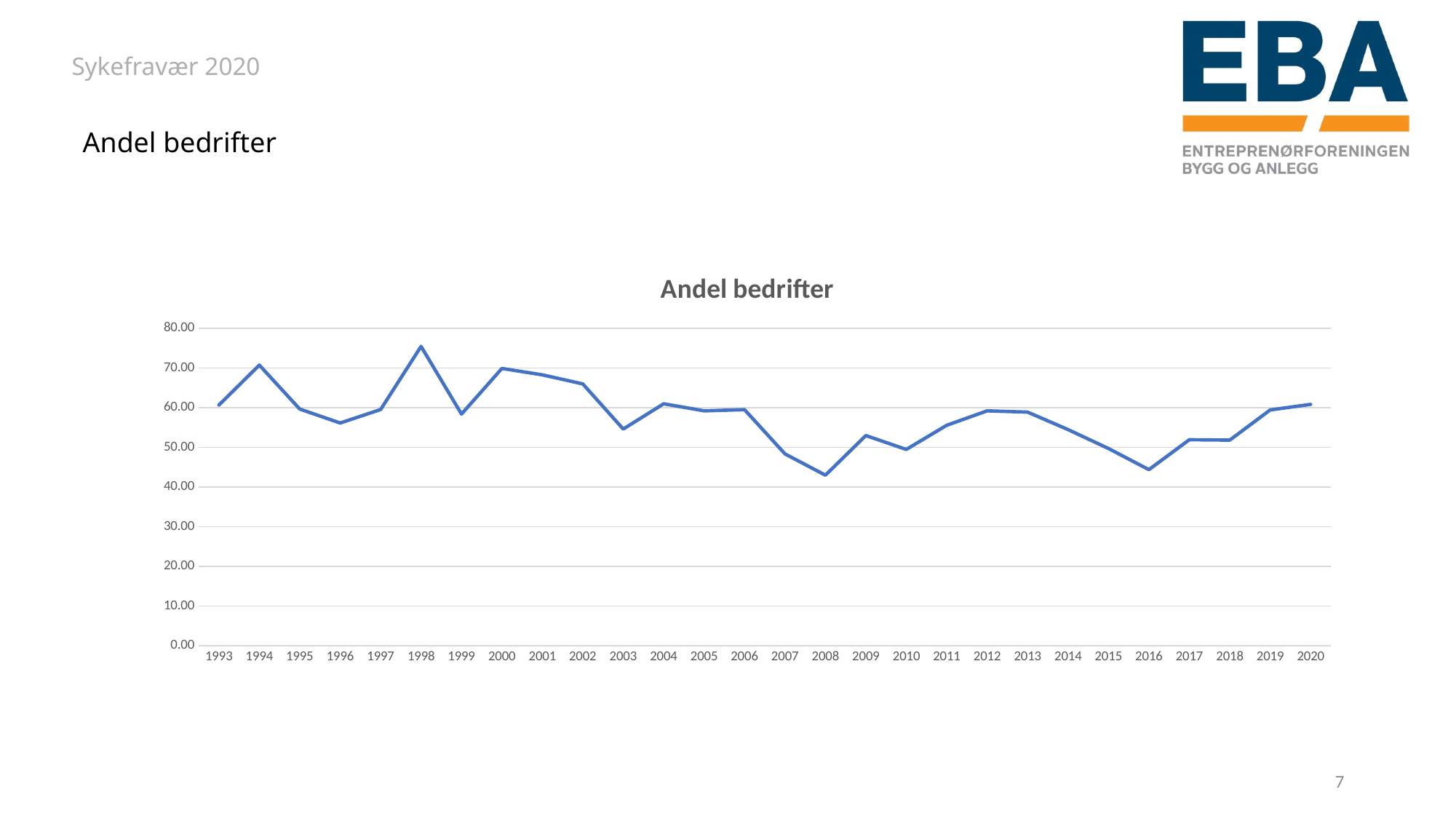
Do the values rise or fall from 2016 to 2020? rise What kind of chart is shown on the slide? line chart Which year has the lowest value in the chart? 2008 Is the value for 1998 greater or less than 70? greater Is the value for 2008 greater or less than 50? less What is the title of the chart? Andel bedrifter Is the value for 2003 greater or less than 60? less Which year has the highest value in the chart? 1998 Do the values rise or fall from 2006 to 2008? fall Which year has the larger value, 2000 or 2003? 2000 How many years are plotted along the x axis of the chart? 28